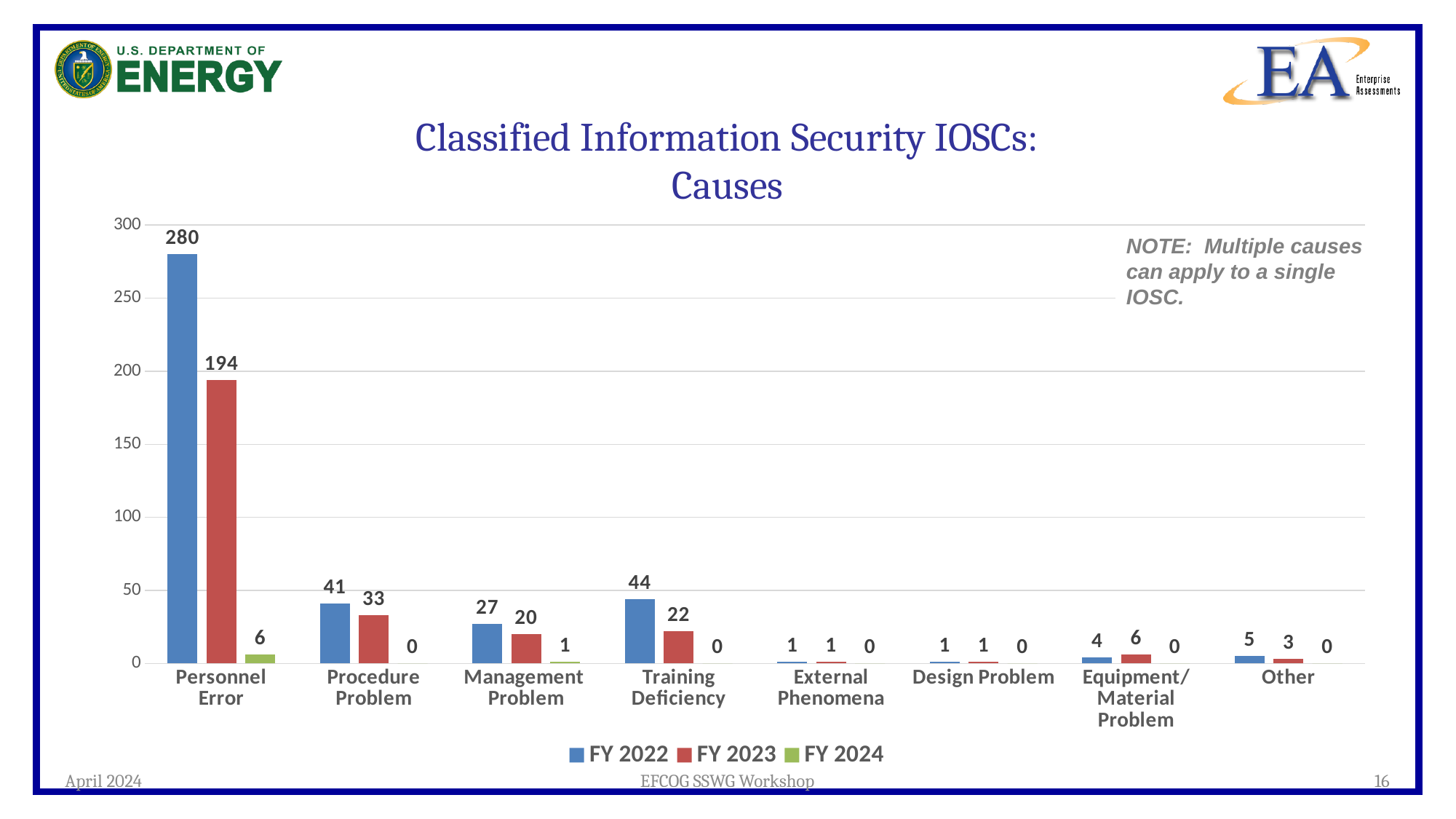
How many cause categories are shown on the x axis? 8 How many series does the legend list? 3 What is the difference between the FY 2022 values for Training Deficiency and Procedure Problem? 3 What is the FY 2023 value for Training Deficiency? 22 Which cause has the highest FY 2023 value? Personnel Error What is the FY 2022 value for Personnel Error? 280 What type of chart is shown on the slide? Bar chart What is the FY 2023 value for Equipment/Material Problem? 6 Which cause has the highest FY 2024 value? Personnel Error What is the difference between the FY 2022 and FY 2023 values for Personnel Error? 86 Which is larger, the FY 2022 value for Procedure Problem or the FY 2022 value for Management Problem? Procedure Problem What is the FY 2024 value for Management Problem? 1